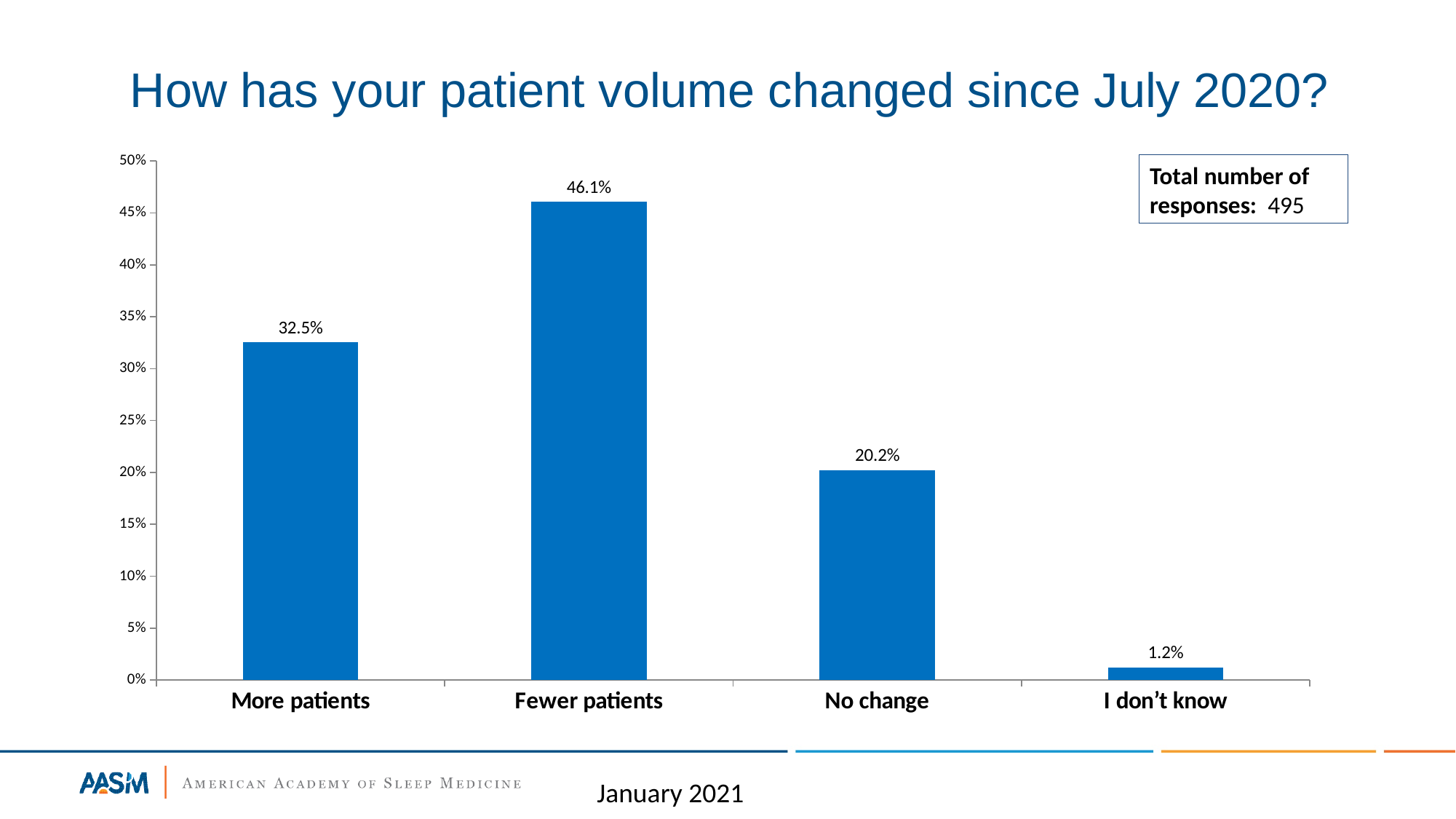
What percentage of respondents reported more patients? 32.5% What is the title of the chart on the slide? How has your patient volume changed since July 2020? Which response category has the highest percentage? Fewer patients What is the difference in percentage points between 'Fewer patients' and 'More patients'? 13.6 percentage points What is the total number of responses stated on the slide? 495 What percentage of respondents reported fewer patients? 46.1% How many response categories are shown on the chart? 4 Which is larger, the percentage for 'More patients' or for 'No change'? More patients What percentage of respondents answered 'I don't know'? 1.2% Which response category has the lowest percentage? I don't know What percentage of respondents reported no change in patient volume? 20.2% What kind of chart is shown on the slide? Bar chart